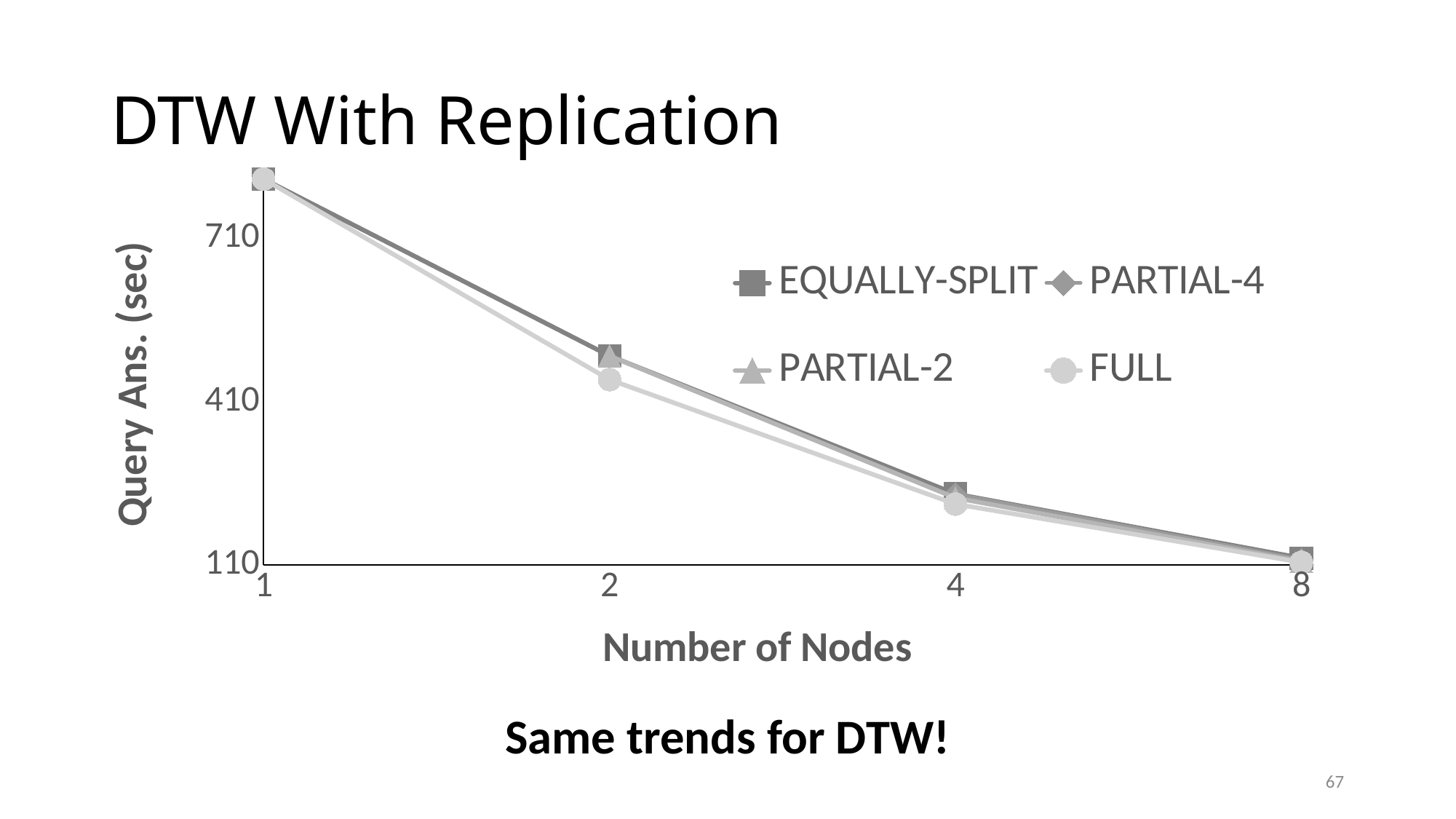
At 2 nodes, which is larger: the value for EQUALLY-SPLIT or the value for FULL? EQUALLY-SPLIT Is the value for FULL at 8 nodes greater or less than 410? less At which number of nodes is the query answer time lowest? 8 What kind of chart is shown on the slide? line chart How many points are plotted along the x axis (Number of Nodes)? 4 How many series does the legend list? 4 What is the title of the y axis? Query Ans. (sec) Do the query answer times rise or fall as the number of nodes increases? fall Is the value for EQUALLY-SPLIT at 1 node greater or less than 710? greater Is the value for PARTIAL-4 at 4 nodes greater or less than 410? less At which number of nodes is the query answer time highest? 1